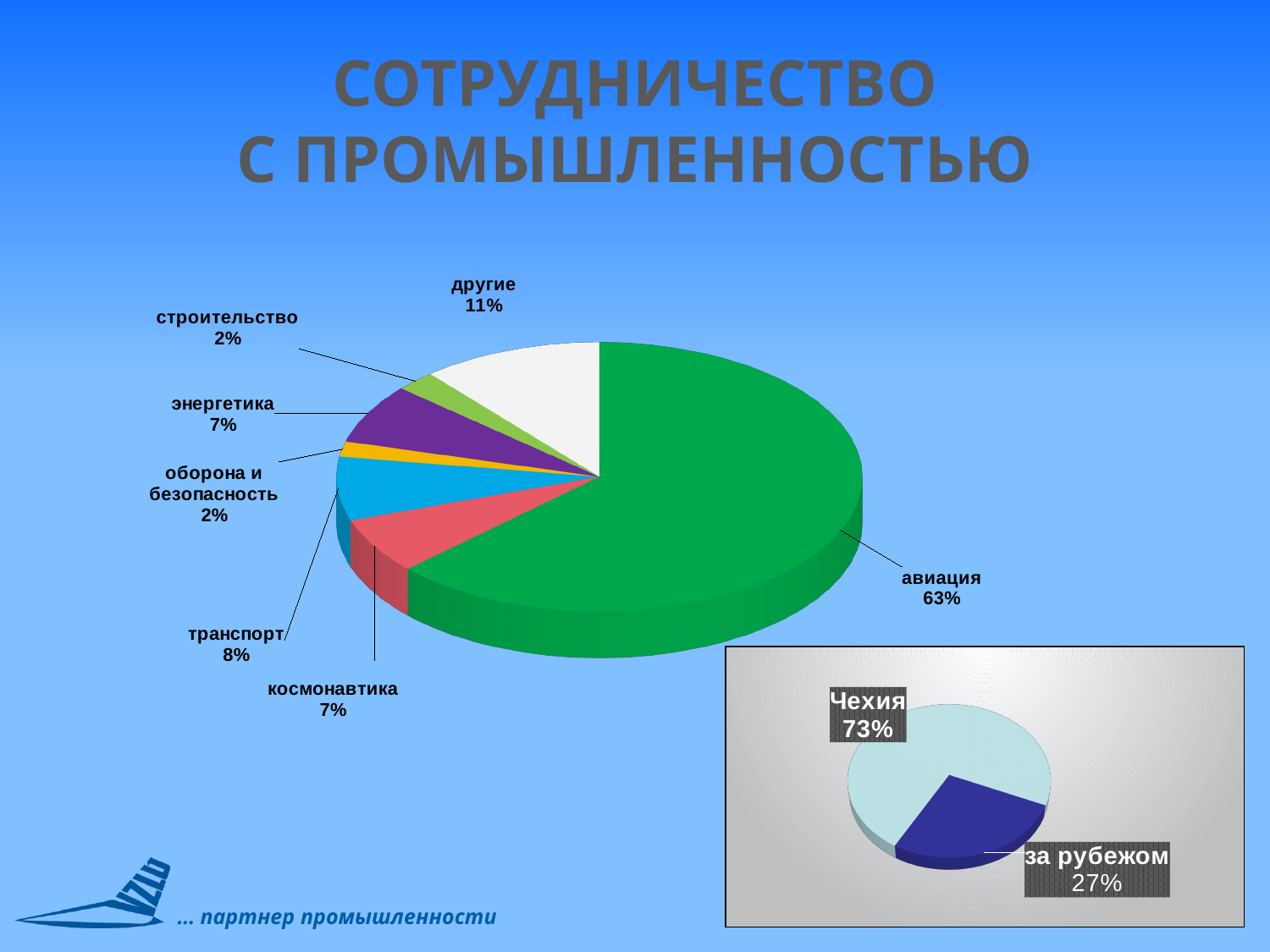
In the large pie chart, what is the difference between the shares of авиация and другие? 52% In the small pie chart at the bottom right, which category has the smallest share? за рубежом In the large pie chart, which has a larger share, транспорт or энергетика? транспорт In the large pie chart, what share does авиация have? 63% In the large pie chart, what colour is the авиация slice? green In the small pie chart at the bottom right, what share does Чехия have? 73% In the large pie chart, what share does транспорт have? 8% In the large pie chart, what share does другие have? 11% How many categories does the large pie chart show? 7 In the large pie chart, which category has the largest share? авиация What kind of chart is the large chart on the slide? pie chart How many categories does the small pie chart at the bottom right show? 2